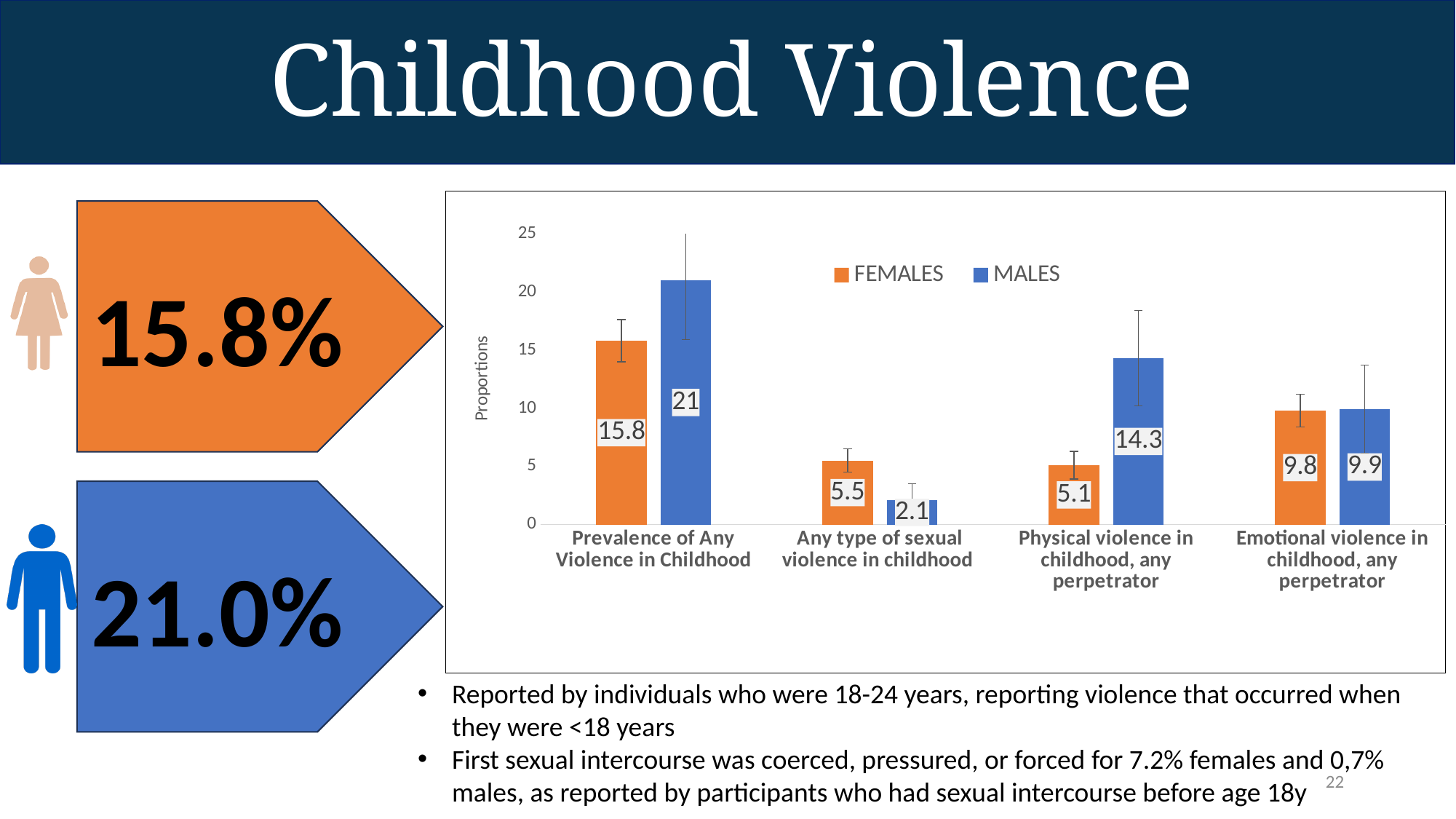
For Any type of sexual violence in childhood, which series has the larger value, FEMALES or MALES? FEMALES What is the difference between the MALES and FEMALES values for Physical violence in childhood, any perpetrator? 9.2 Which category has the lowest value for FEMALES? Physical violence in childhood, any perpetrator What type of chart is shown on the slide? Bar chart What is the value for MALES for Physical violence in childhood, any perpetrator? 14.3 Which category has the highest value for MALES? Prevalence of Any Violence in Childhood Is the MALES value for Prevalence of Any Violence in Childhood greater or less than 20? greater How many series does the chart legend list? 2 What is the value for FEMALES for Prevalence of Any Violence in Childhood? 15.8 What is the value for FEMALES for Emotional violence in childhood, any perpetrator? 9.8 How many categories are shown on the x axis of the chart? 4 What is the value for MALES for Any type of sexual violence in childhood? 2.1